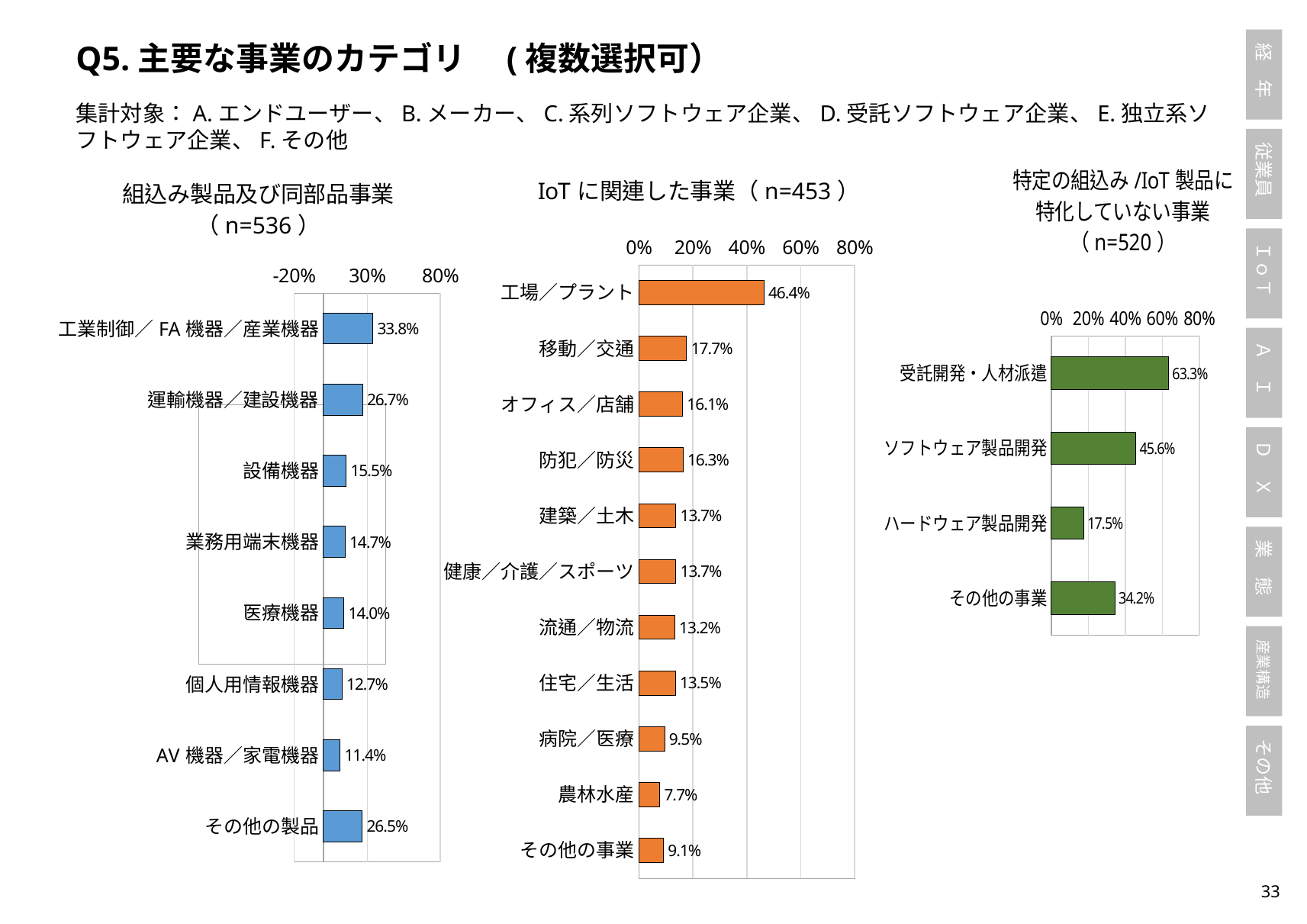
How many categories are shown in the IoT に関連した事業 chart? 11 In the 特定の組込み/IoT製品に特化していない事業 chart, what is the value for ソフトウェア製品開発? 45.6% In the 特定の組込み/IoT製品に特化していない事業 chart, which category has the highest value? 受託開発・人材派遣 In the 特定の組込み/IoT製品に特化していない事業 chart, what is the difference between 受託開発・人材派遣 and ハードウェア製品開発? 45.8% In the 組込み製品及び同部品事業 chart, what is the value for 工業制御／FA機器／産業機器? 33.8% In the 組込み製品及び同部品事業 chart, which category has the lowest value? AV機器／家電機器 In the IoT に関連した事業 chart, which is larger, 移動／交通 or オフィス／店舗? 移動／交通 In the IoT に関連した事業 chart, which category has the lowest value? 農林水産 In the IoT に関連した事業 chart, what is the value for 工場／プラント? 46.4% What type of chart is the IoT に関連した事業 chart? Bar chart In the 組込み製品及び同部品事業 chart, what is the difference between 運輸機器／建設機器 and その他の製品? 0.2% How many categories are shown in the 組込み製品及び同部品事業 chart? 8